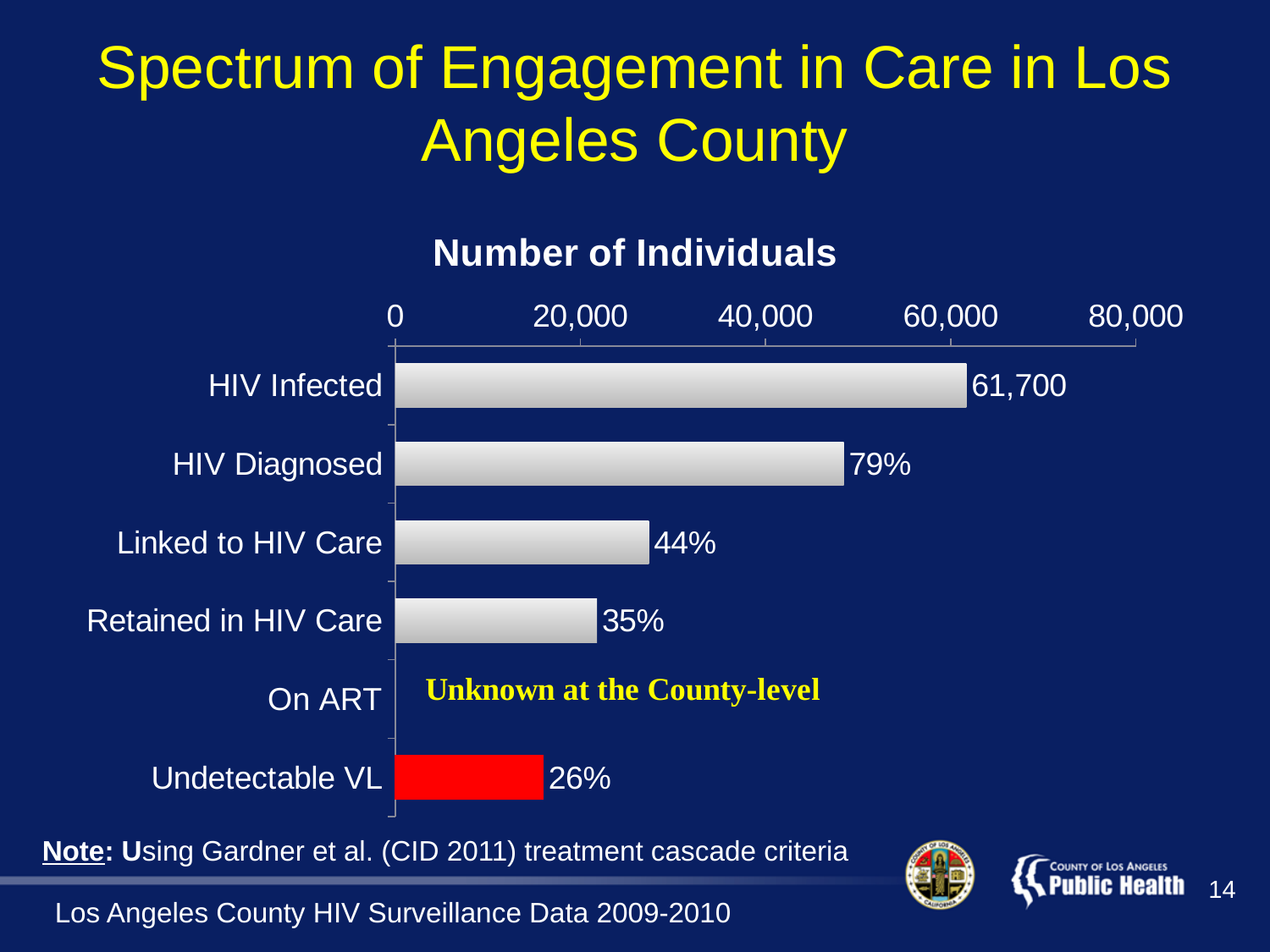
What kind of chart is shown on the slide? Bar chart What is the data label shown for HIV Infected? 61,700 Is the bar for HIV Diagnosed greater or less than 40,000 individuals? greater What text is shown in place of a bar for On ART? Unknown at the County-level How many categories are listed on the vertical axis of the chart? 6 Which category has the shortest bar? Undetectable VL What is the data label shown for Linked to HIV Care? 44% What is the data label shown for Undetectable VL? 26% What is the data label shown for Retained in HIV Care? 35% Is the bar for Undetectable VL greater or less than 20,000 individuals? less Which category has the longest bar? HIV Infected What is the data label shown for HIV Diagnosed? 79%